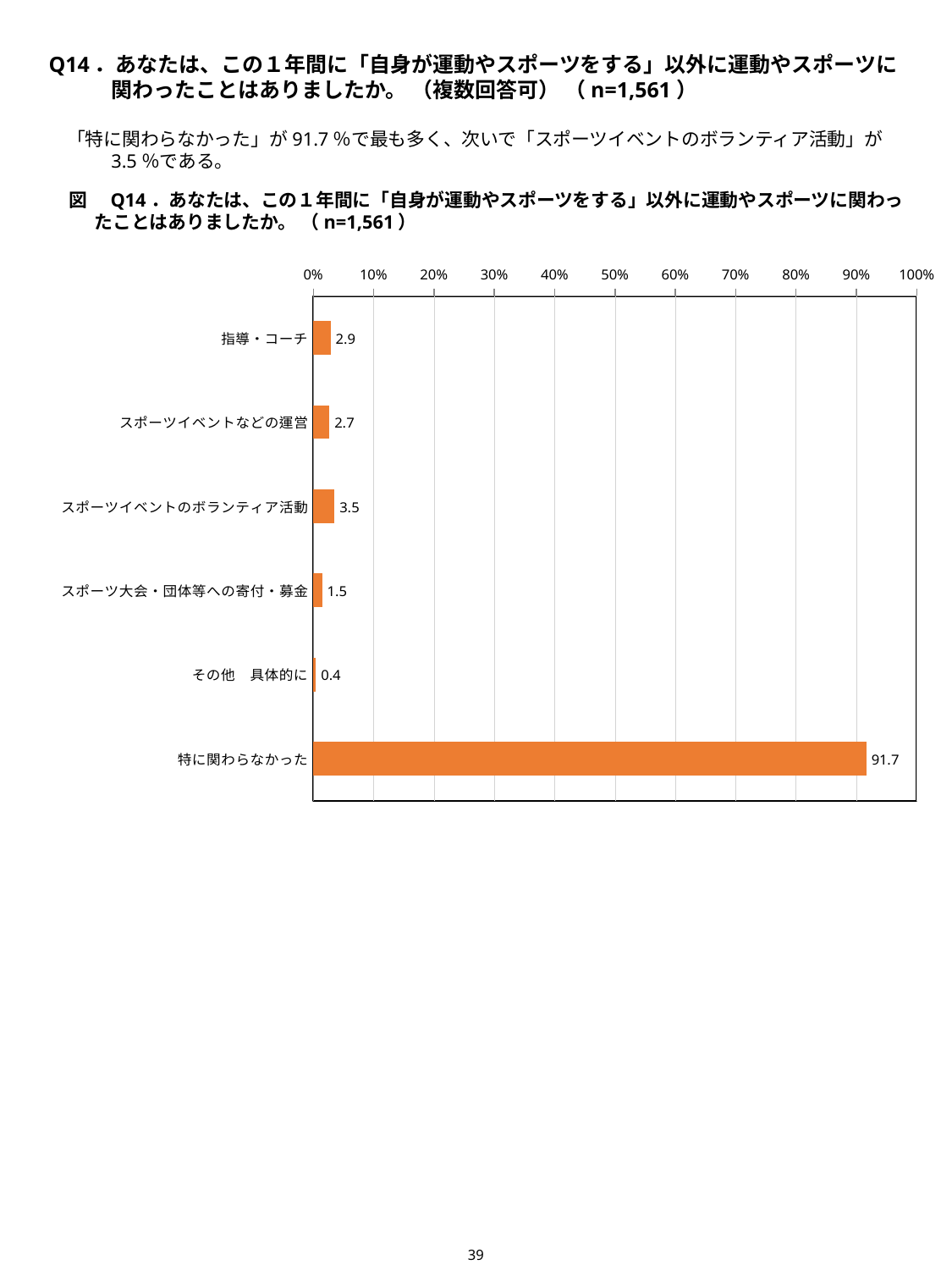
Which category has the highest value? 特に関わらなかった What is the difference between the values for 指導・コーチ and スポーツイベントなどの運営? 0.2 What is the value for 指導・コーチ? 2.9 What is the difference between the values for スポーツイベントのボランティア活動 and スポーツ大会・団体等への寄付・募金? 2.0 Is the value for 特に関わらなかった greater or less than 90%? greater What is the value for 特に関わらなかった? 91.7 What is the value for その他 具体的に? 0.4 Which is larger, the value for スポーツイベントのボランティア活動 or the value for 指導・コーチ? スポーツイベントのボランティア活動 What is the value for スポーツイベントのボランティア活動? 3.5 How many categories are shown in the chart? 6 What kind of chart is shown on the slide? bar chart Which category has the lowest value? その他 具体的に